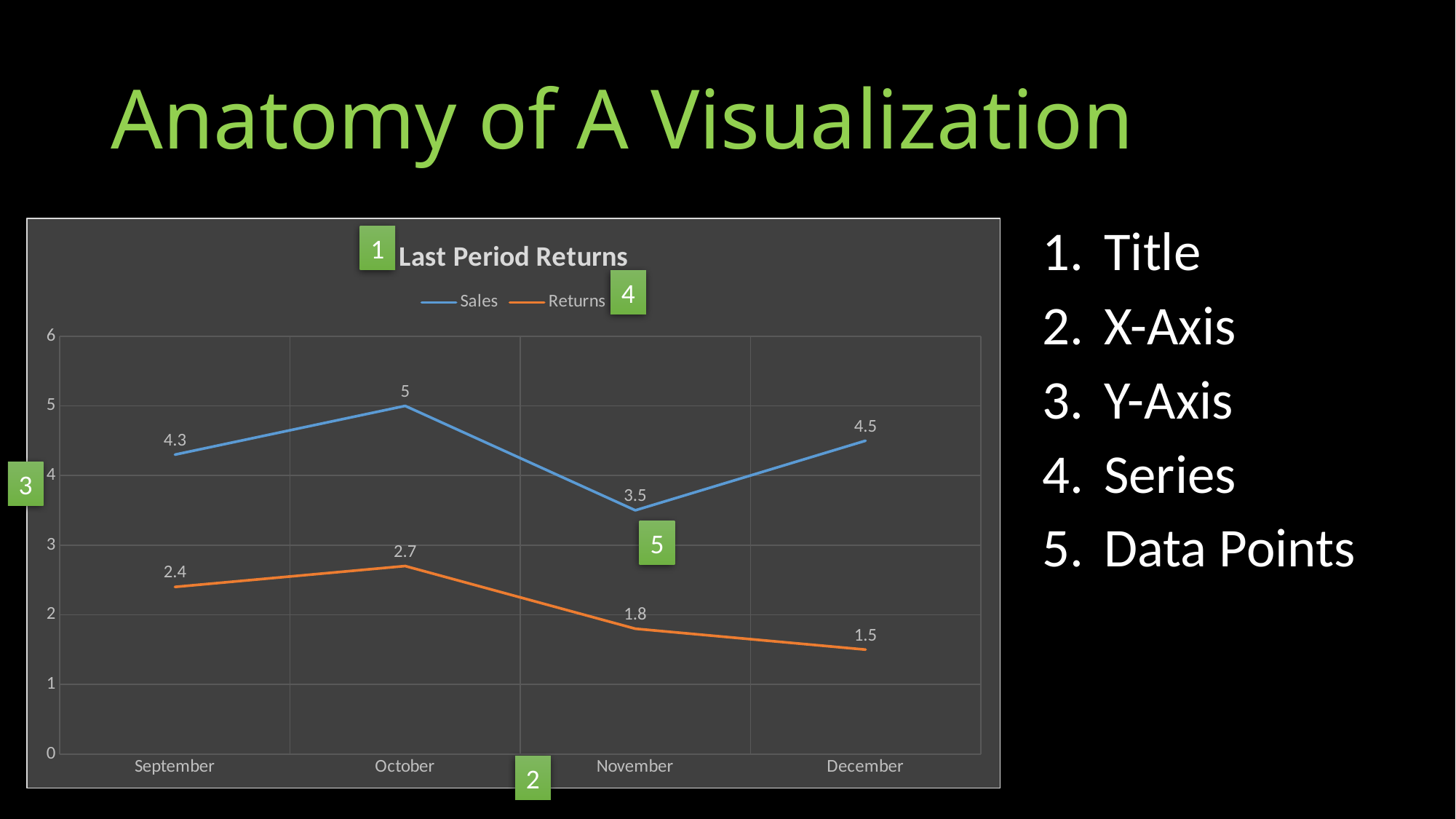
What is the Returns value for November? 1.8 What is the title of the chart? Last Period Returns In which month is Returns lowest? December How many series does the legend list? 2 What is the Sales value for October? 5 What is the Sales value for December? 4.5 How many months are shown on the x-axis? 4 What kind of chart is shown? line chart Is the Returns value for October greater or less than 3? less In which month is Sales highest? October What is the difference between Sales and Returns in September? 1.9 Which is larger, Sales in November or Sales in December? Sales in December